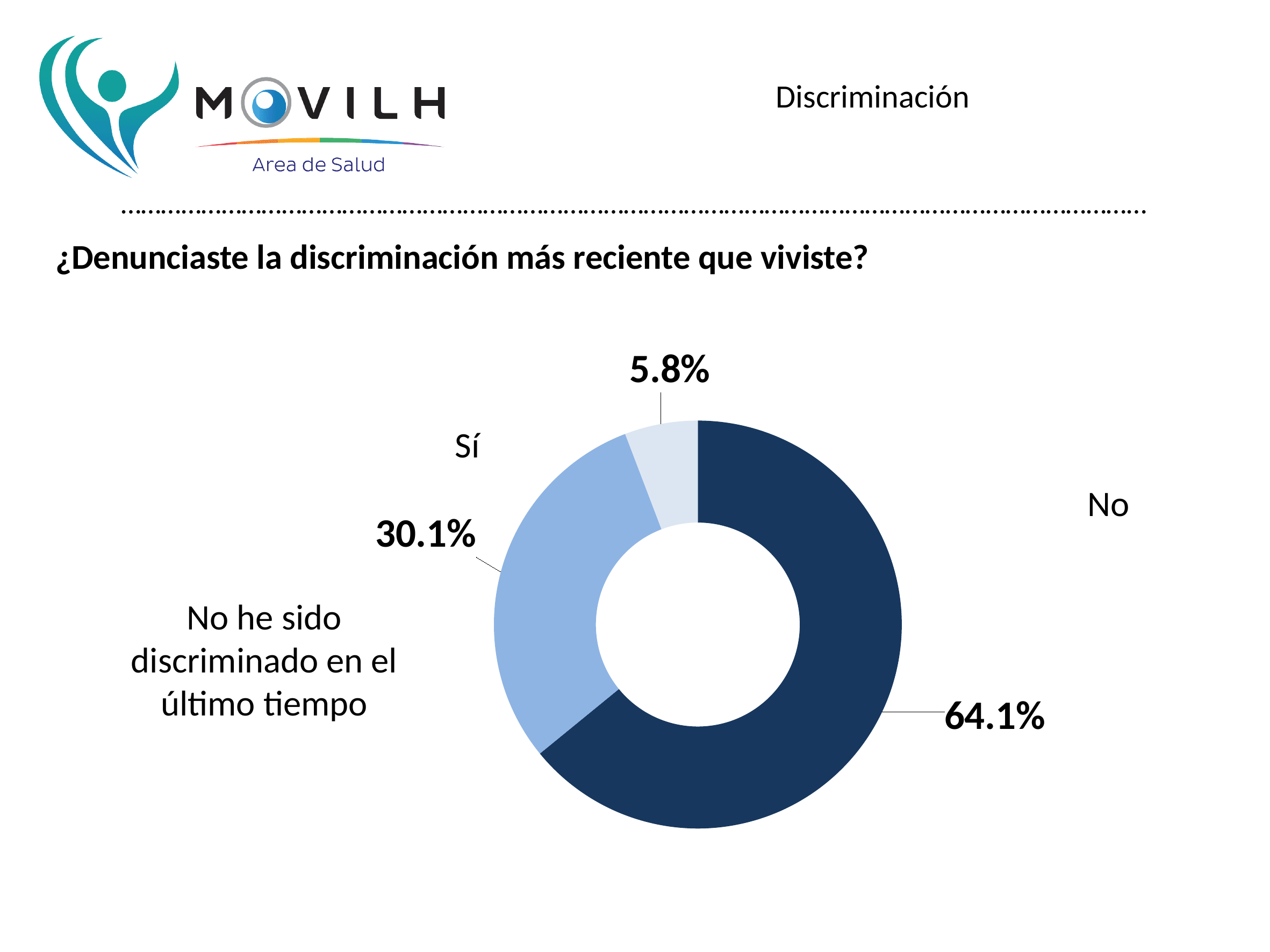
What kind of chart is shown on the slide? Donut (pie) chart How many response categories are shown in the chart? 3 Which response has the largest share of the chart? No Which response has the smallest share of the chart? Sí What is the difference in percentage points between the "No" and "Sí" responses? 58.3 What percentage of respondents answered "No he sido discriminado en el último tiempo"? 30.1% What percentage of respondents answered "No"? 64.1% Which response is shown in the darkest blue slice? No What is the difference in percentage points between "No" and "No he sido discriminado en el último tiempo"? 34 What percentage of respondents answered "Sí"? 5.8% Which is larger, the share for "Sí" or the share for "No he sido discriminado en el último tiempo"? No he sido discriminado en el último tiempo What question does the chart answer, according to the slide heading? ¿Denunciaste la discriminación más reciente que viviste?